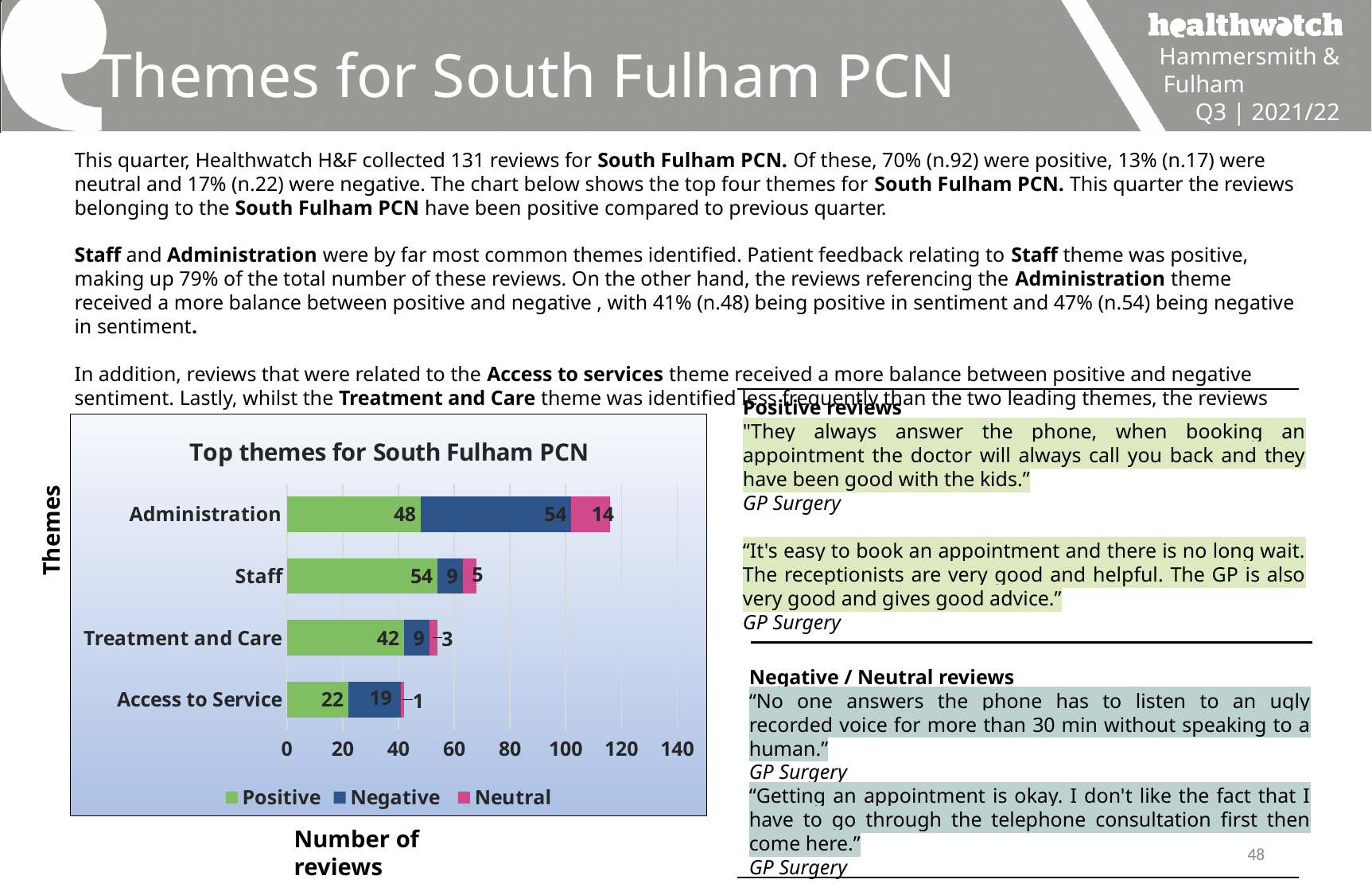
What is the title of the chart? Top themes for South Fulham PCN What type of chart is shown on the slide? Stacked bar chart What is the Positive value for Administration? 48 Which theme has the highest Positive value? Staff How many series does the chart legend list? 3 What is the Negative value for Access to Service? 19 What is the difference between the Positive values for Staff and Treatment and Care? 12 How many themes are plotted in the chart? 4 What is the Negative value for Administration? 54 Which theme has the lowest Neutral value? Access to Service What is the Neutral value for Staff? 5 What is the total number of reviews for the Administration bar? 116